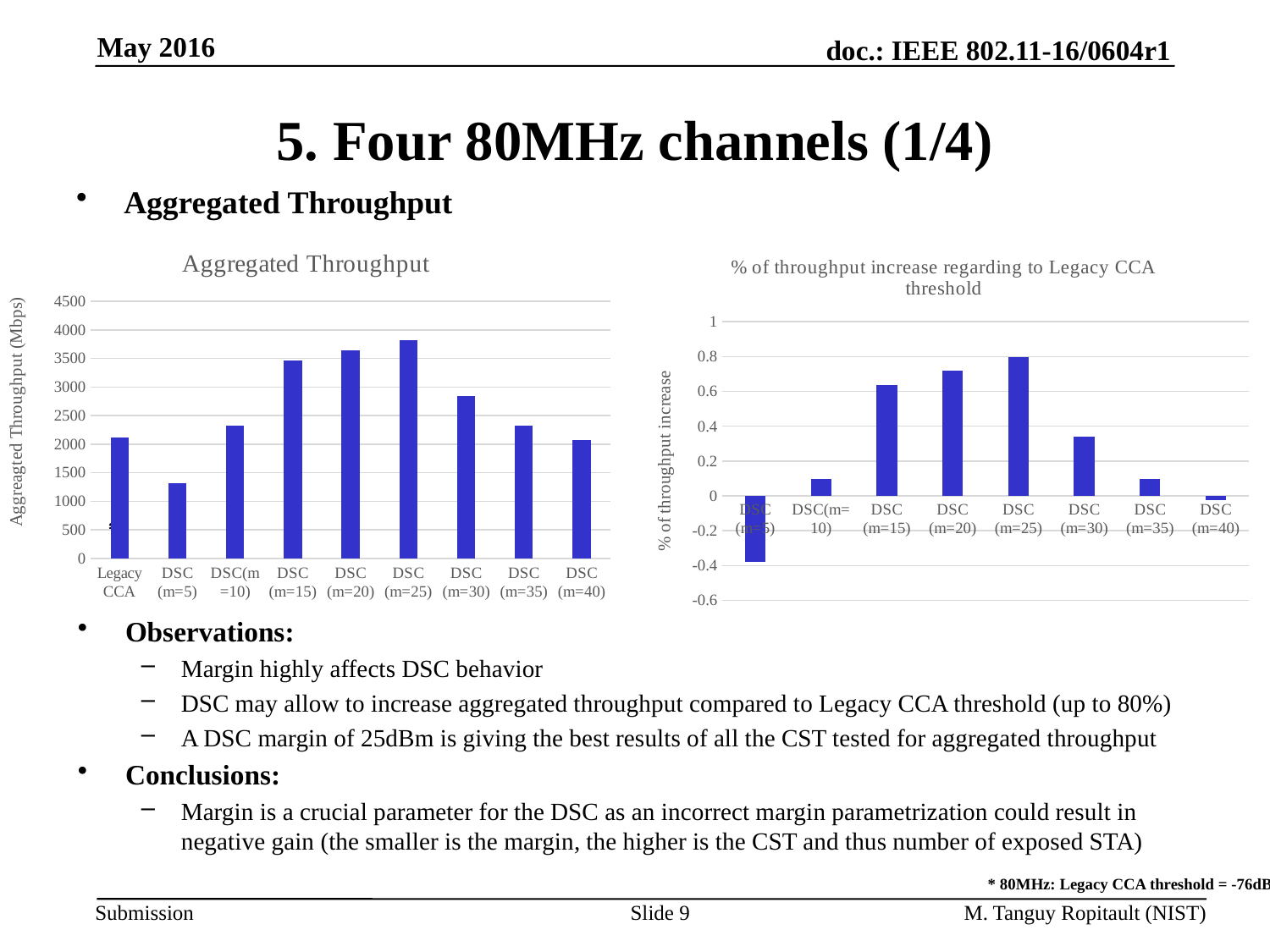
In the '% of throughput increase regarding to Legacy CCA threshold' chart, which category has the lowest value? DSC (m=5) In the 'Aggregated Throughput' chart, which category has the lowest aggregated throughput? DSC (m=5) In the 'Aggregated Throughput' chart, which category has the highest aggregated throughput? DSC (m=25) In the 'Aggregated Throughput' chart, how many categories are plotted on the x axis? 9 What kind of chart is the 'Aggregated Throughput' chart on the left? bar chart In the '% of throughput increase regarding to Legacy CCA threshold' chart, how many categories are plotted? 8 In the 'Aggregated Throughput' chart, which is larger, the value for DSC (m=20) or DSC (m=30)? DSC (m=20) In the 'Aggregated Throughput' chart, is the value for DSC (m=5) greater or less than 1500? less In the '% of throughput increase regarding to Legacy CCA threshold' chart, is the value for DSC (m=5) greater or less than -0.2? less In the 'Aggregated Throughput' chart, is the value for DSC (m=15) greater or less than 3000? greater What is the y-axis label of the 'Aggregated Throughput' chart? Aggreagted Throughput (Mbps) In the '% of throughput increase regarding to Legacy CCA threshold' chart, which category has the highest value? DSC (m=25)